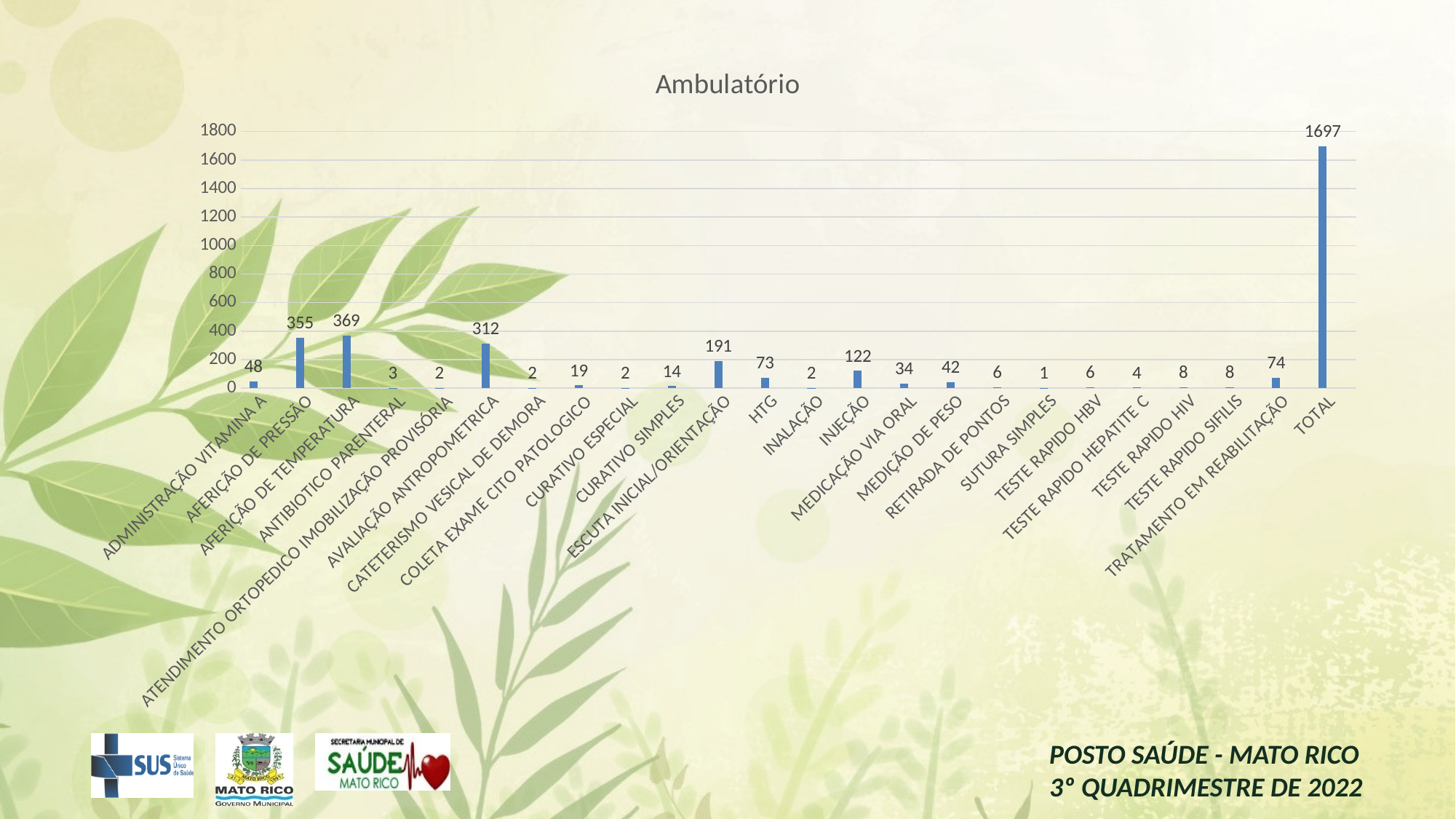
What is the value for TOTAL? 1697 What is the title of the chart? Ambulatório Which is larger, the value for INJEÇÃO or the value for HTG? INJEÇÃO What is the value for TRATAMENTO EM REABILITAÇÃO? 74 What is the difference between the values for AFERIÇÃO DE TEMPERATURA and AVALIAÇÃO ANTROPOMETRICA? 57 Excluding the TOTAL bar, which category has the highest value? AFERIÇÃO DE TEMPERATURA How many categories are shown on the x axis, including TOTAL? 24 Is the value for TOTAL greater or less than 1600? greater Which category has the lowest value? SUTURA SIMPLES What is the value for ESCUTA INICIAL/ORIENTAÇÃO? 191 What kind of chart is shown on the slide? bar chart What is the value for AFERIÇÃO DE PRESSÃO? 355